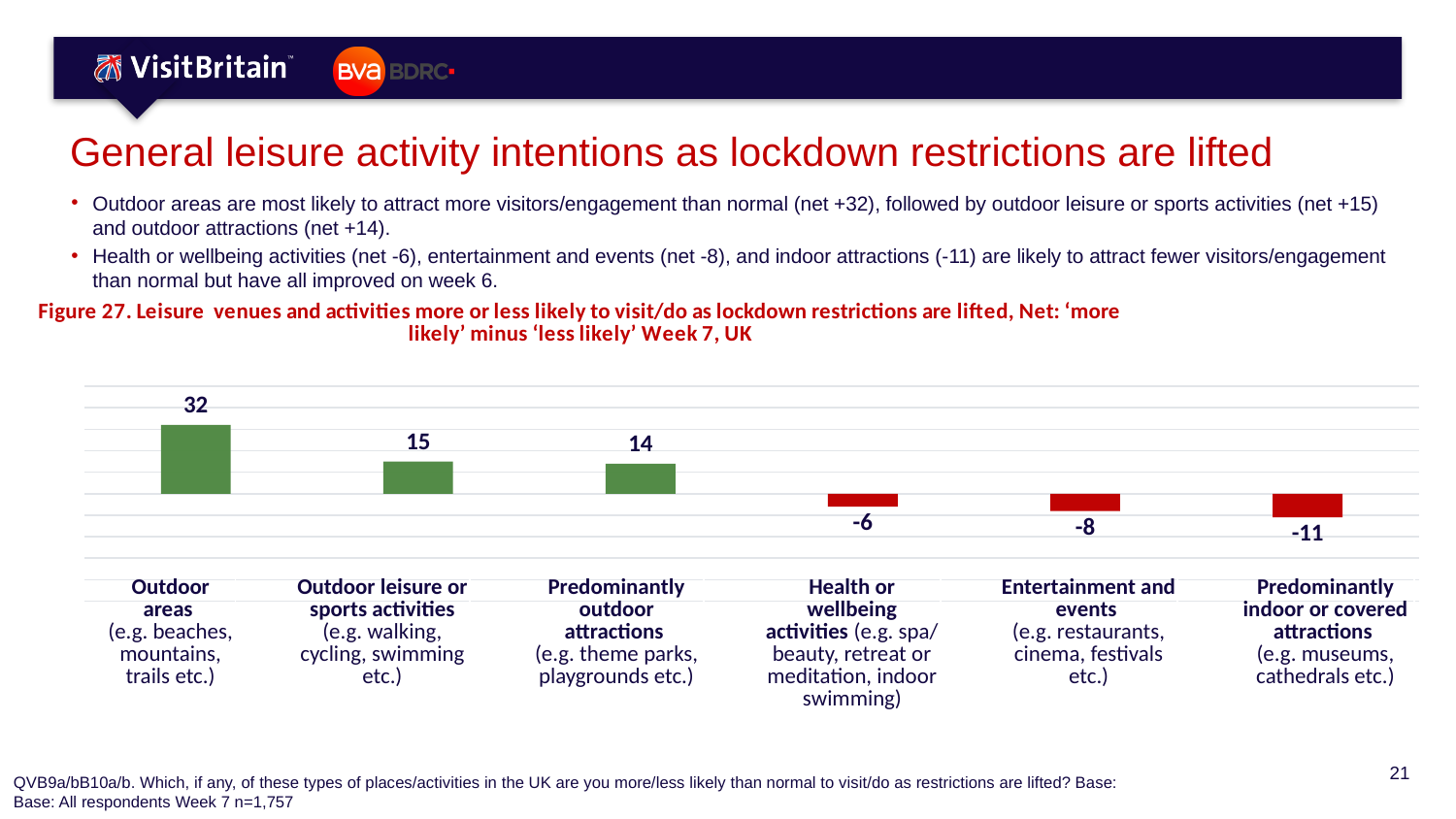
What is the net value for Health or wellbeing activities? -6 What is the difference between the net values for Outdoor areas and Outdoor leisure or sports activities? 17 Which has a higher net value, Outdoor leisure or sports activities or Predominantly outdoor attractions? Outdoor leisure or sports activities What is the net value for Outdoor areas? 32 What colour are the bars with negative net values? Red Do the net values rise or fall moving from left to right across the categories? Fall Which category has the lowest net value? Predominantly indoor or covered attractions Which category has the highest net value? Outdoor areas What is the net value for Predominantly indoor or covered attractions? -11 What kind of chart is shown on the slide? Bar chart What is the difference between the net values for Entertainment and events and Predominantly indoor or covered attractions? 3 How many categories are shown in the chart? 6